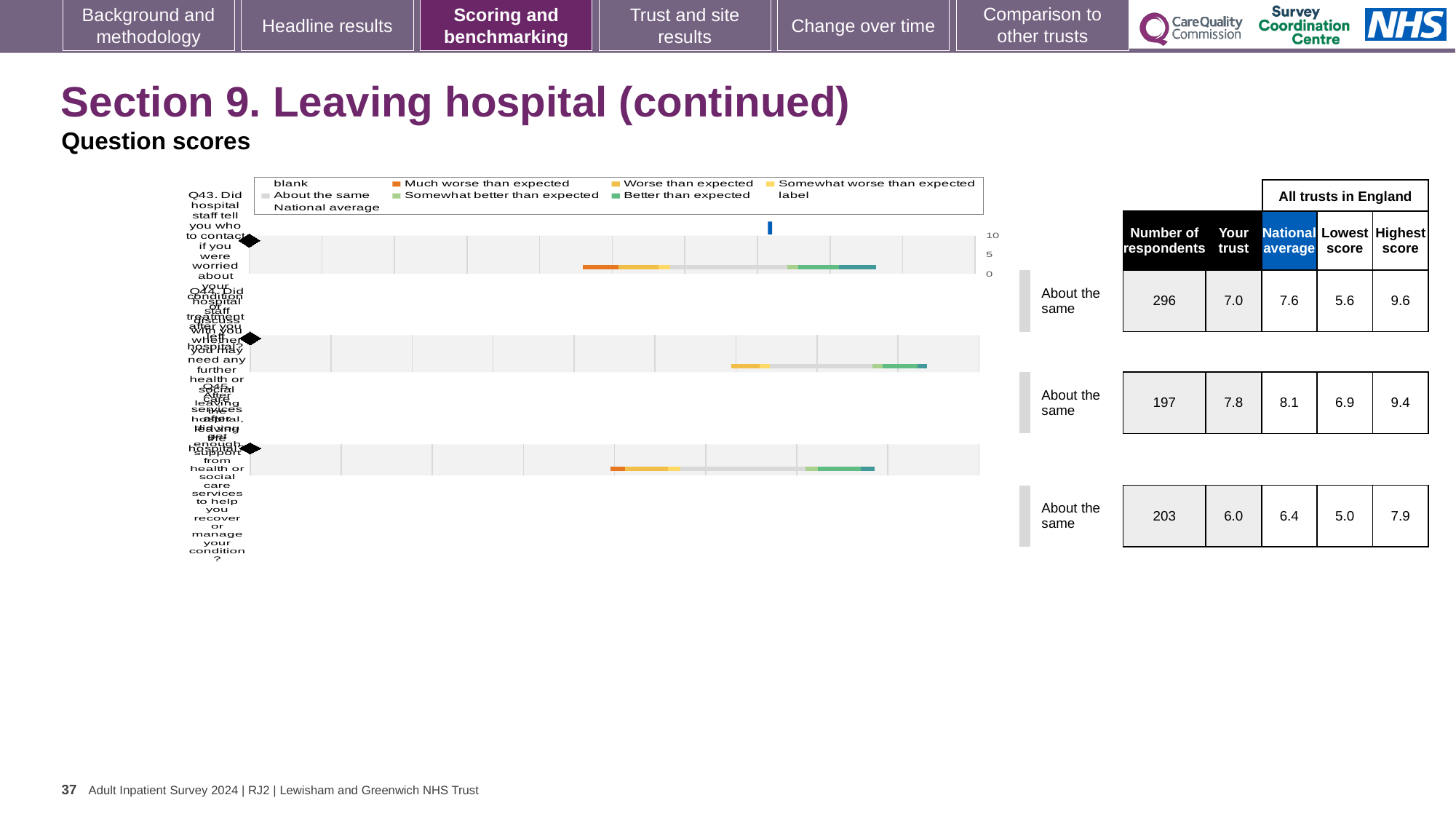
What is the maximum value shown on the score axis of the benchmark charts? 10 For Q43, what is the 'Your trust' score shown in the table beside the chart? 7.0 Which question (Q43, Q44 or Q45) has the lowest 'Your trust' score? Q45 What benchmark category label is shown next to each of the three charts? About the same For Q43, what is the difference between the national average score and the 'Your trust' score? 0.6 For Q45, how many respondents are shown in the table beside the chart? 203 What kind of chart is used to show the question scores on this slide? bar chart What is the highest score among all trusts in England for Q43? 9.6 For Q44, what is the national average score shown in the table beside the chart? 8.1 How many questions (Q43, Q44, Q45) have a benchmark chart on this slide? 3 Which question (Q43, Q44 or Q45) has the highest 'Your trust' score? Q44 For Q45, which is larger: the 'Your trust' score or the national average score? national average